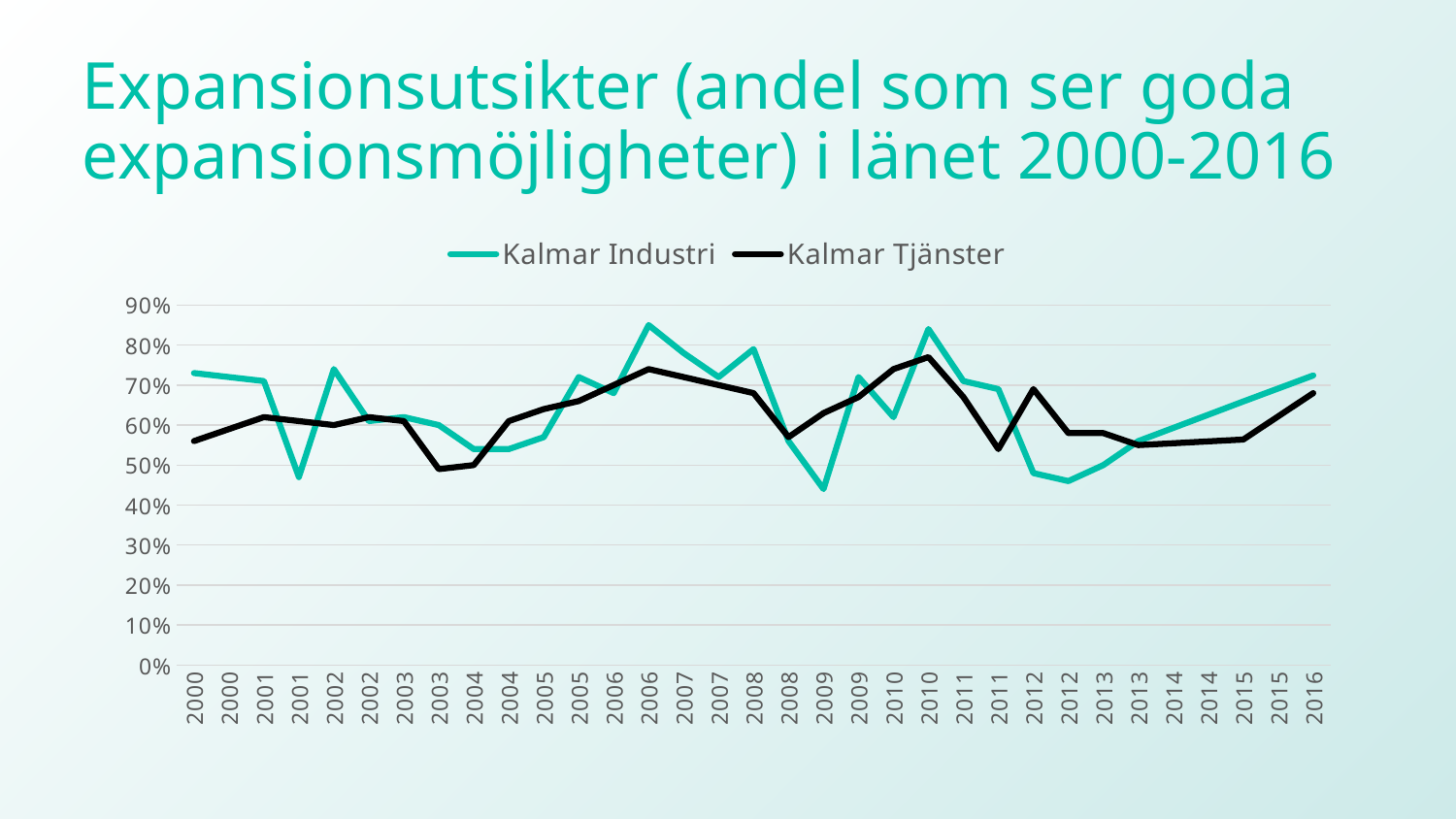
In which year does the Kalmar Industri line reach its highest value? 2006 Is the first 2000 value for Kalmar Industri greater or less than 70%? greater In which year does the Kalmar Tjänster line reach its lowest value? 2003 In which year does the Kalmar Tjänster line reach its highest value? 2010 Which two series are listed in the legend? Kalmar Industri and Kalmar Tjänster What colour is the Kalmar Tjänster line? black In which year does the Kalmar Industri line reach its lowest value? 2009 At the first 2000 point, which series has the higher value, Kalmar Industri or Kalmar Tjänster? Kalmar Industri How many series does the legend list? 2 How many points are plotted along the x axis for each series? 33 Does the Kalmar Industri line rise or fall from the second 2013 point to 2016? rise What kind of chart is shown on the slide? line chart